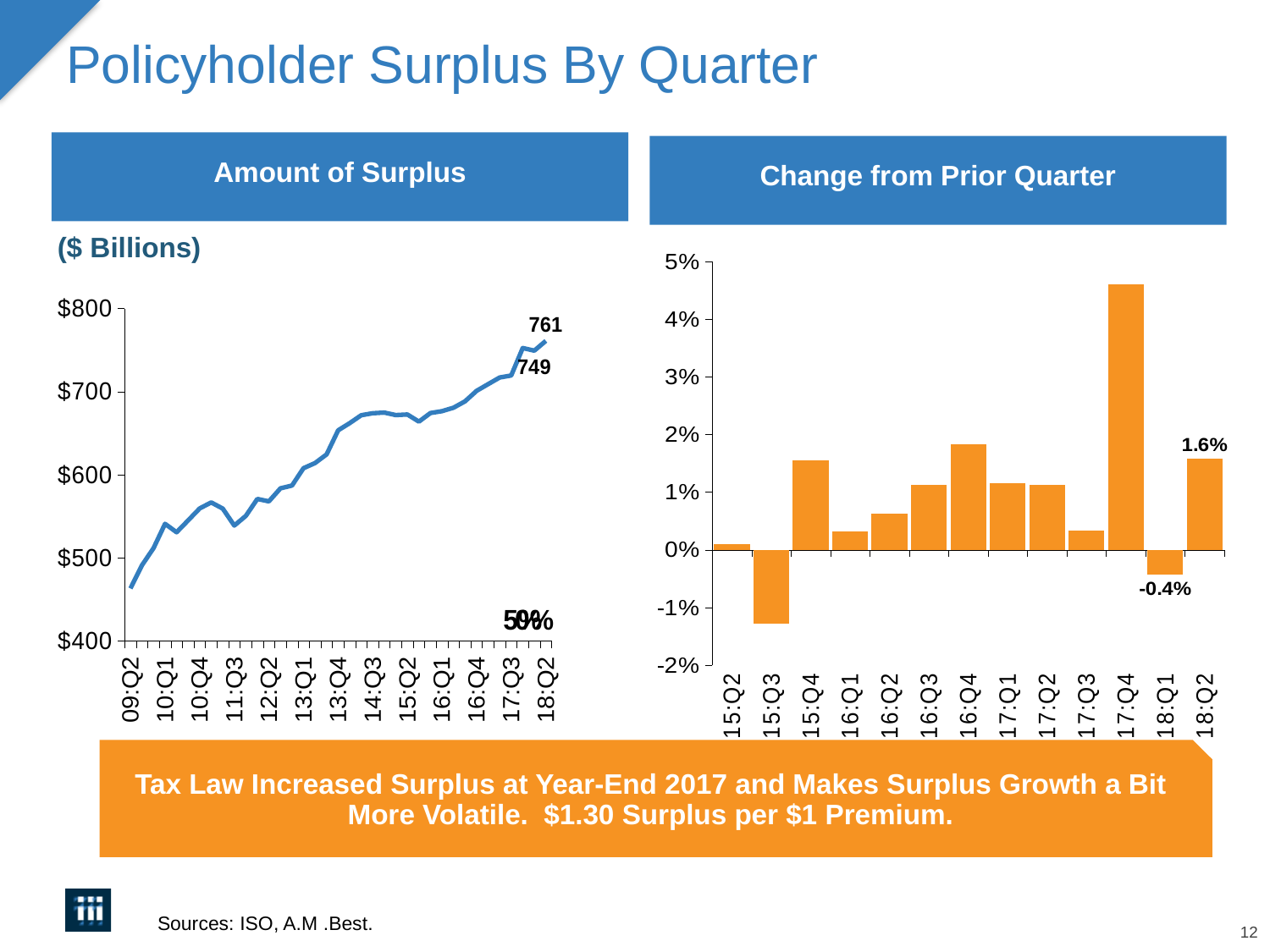
In the 'Change from Prior Quarter' chart, which quarter has the lowest change? 15:Q3 In the 'Amount of Surplus' chart, is the value for 09:Q2 greater or less than $500? less In the 'Change from Prior Quarter' chart, what is the value for 18:Q2? 1.6% In the 'Change from Prior Quarter' chart, what is the difference between the values for 18:Q2 and 18:Q1? 2.0 percentage points In the 'Change from Prior Quarter' chart, which quarter has the highest change? 17:Q4 In the 'Change from Prior Quarter' chart, is the value for 15:Q3 greater or less than -1%? less How many quarters are shown in the 'Change from Prior Quarter' chart? 13 In the 'Change from Prior Quarter' chart, what is the value for 18:Q1? -0.4% In the 'Amount of Surplus' chart, what is the value labeled at the end of the line for 18:Q2? 761 In the 'Change from Prior Quarter' chart, which is larger, the value for 17:Q4 or the value for 18:Q2? 17:Q4 What kind of chart is the 'Change from Prior Quarter' chart? Bar chart In the 'Change from Prior Quarter' chart, is the value for 17:Q4 greater or less than 4%? greater